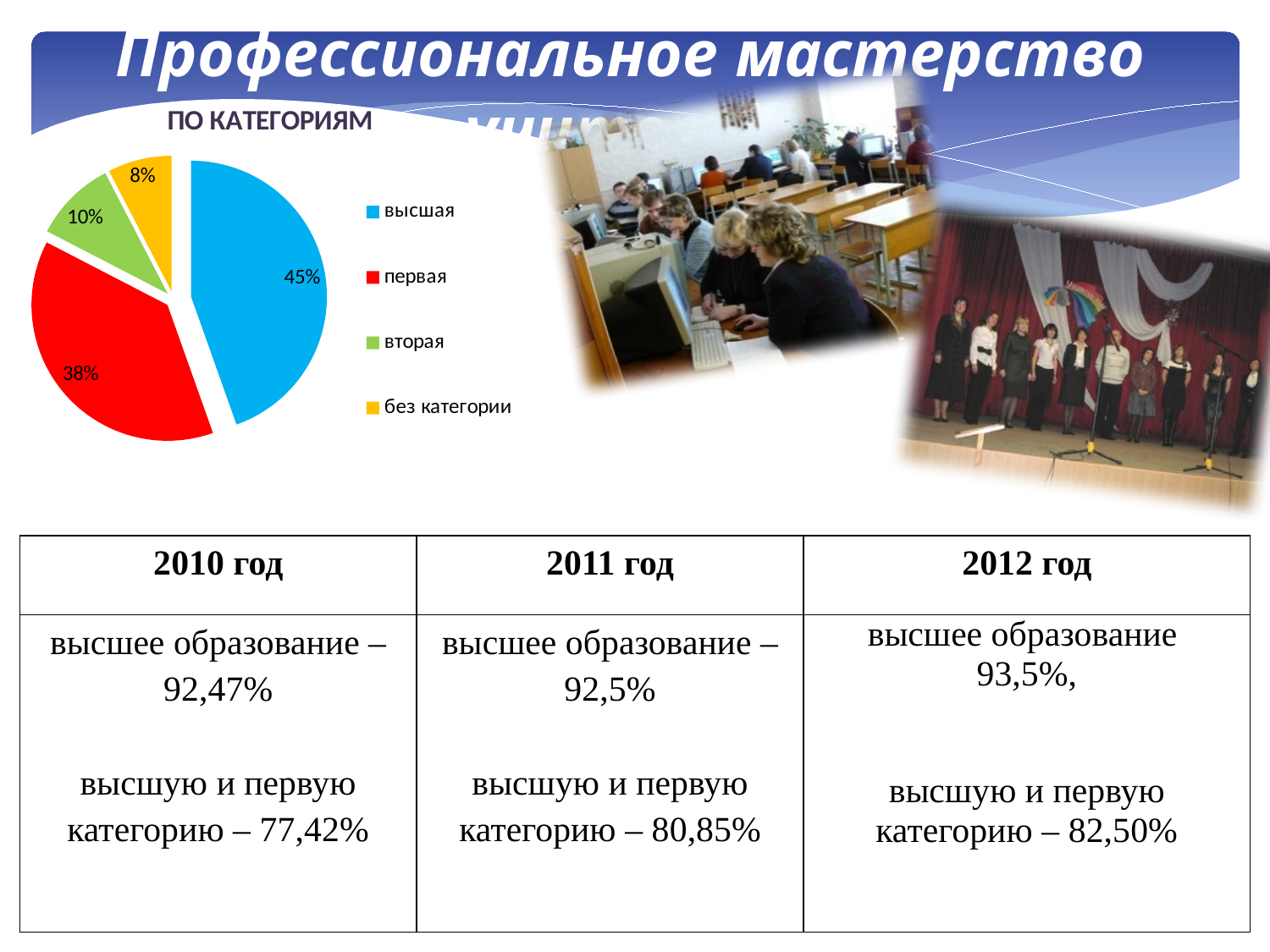
What is the value shown for "без категории"? 8% What share of the pie does the "первая" slice represent? 38% Which is larger, the slice for "вторая" or the slice for "без категории"? вторая Which category has the smallest slice of the pie? без категории How many entries does the legend list? 4 Which category has the largest slice of the pie? высшая What kind of chart is shown on the slide? pie chart How many categories are shown in the pie chart? 4 What is the difference in percentage points between "высшая" and "первая"? 7 What is the value shown for "вторая"? 10% What is the title of the pie chart? ПО КАТЕГОРИЯМ What share of the pie does the "высшая" slice represent? 45%